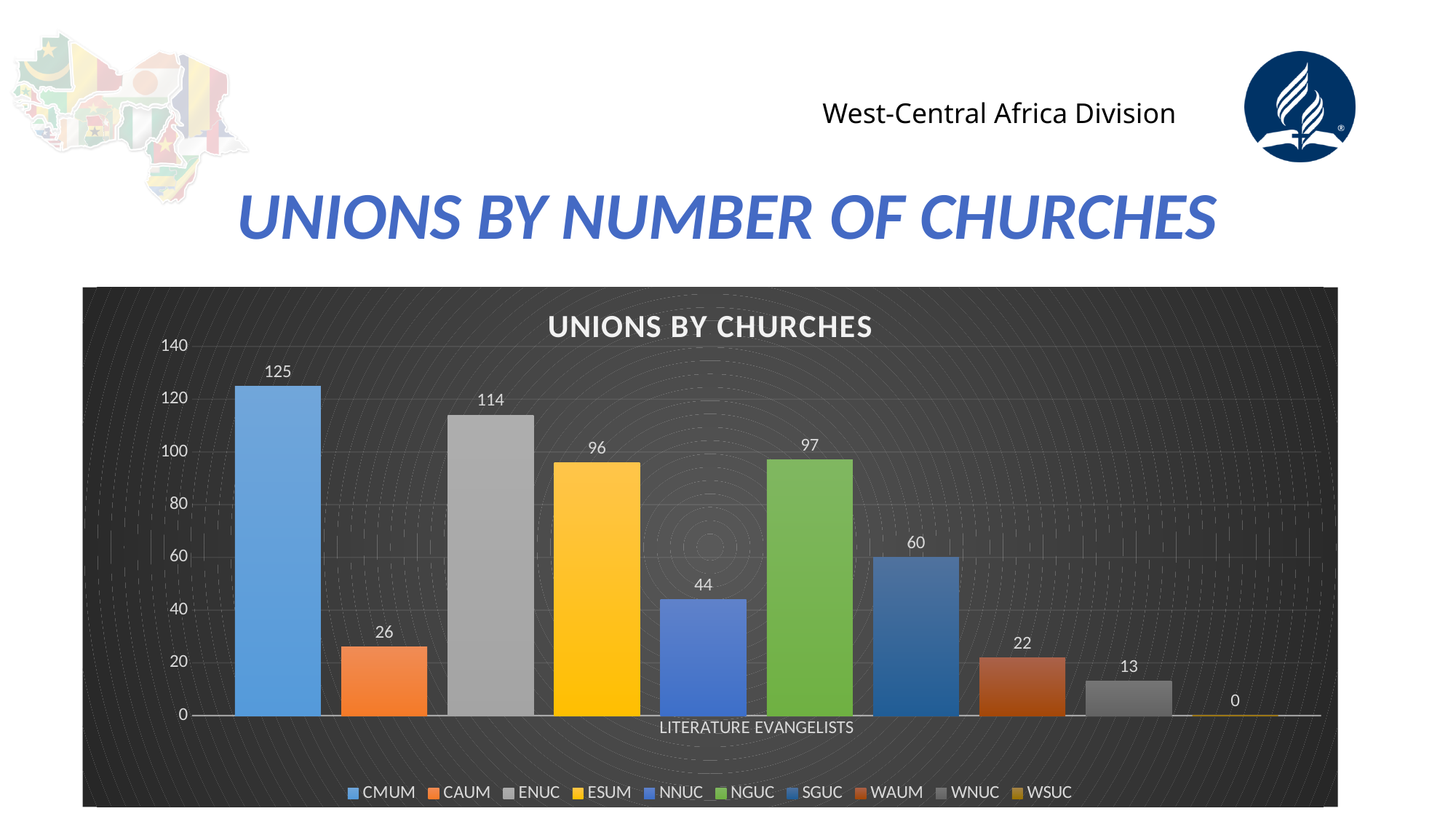
What is the value for CMUM in the chart? 125 Which union has the lowest value in the chart? WSUC What is the difference between the values for CMUM and ENUC? 11 How many series does the legend list? 10 What is the value for NNUC in the chart? 44 What is the title of the chart? UNIONS BY CHURCHES What is the difference between the values for SGUC and WAUM? 38 What is the value for WNUC in the chart? 13 Which union has the highest value in the chart? CMUM What is the value for ENUC in the chart? 114 Which is larger, the value for CAUM or the value for NNUC? NNUC What kind of chart is shown on the slide? Bar chart